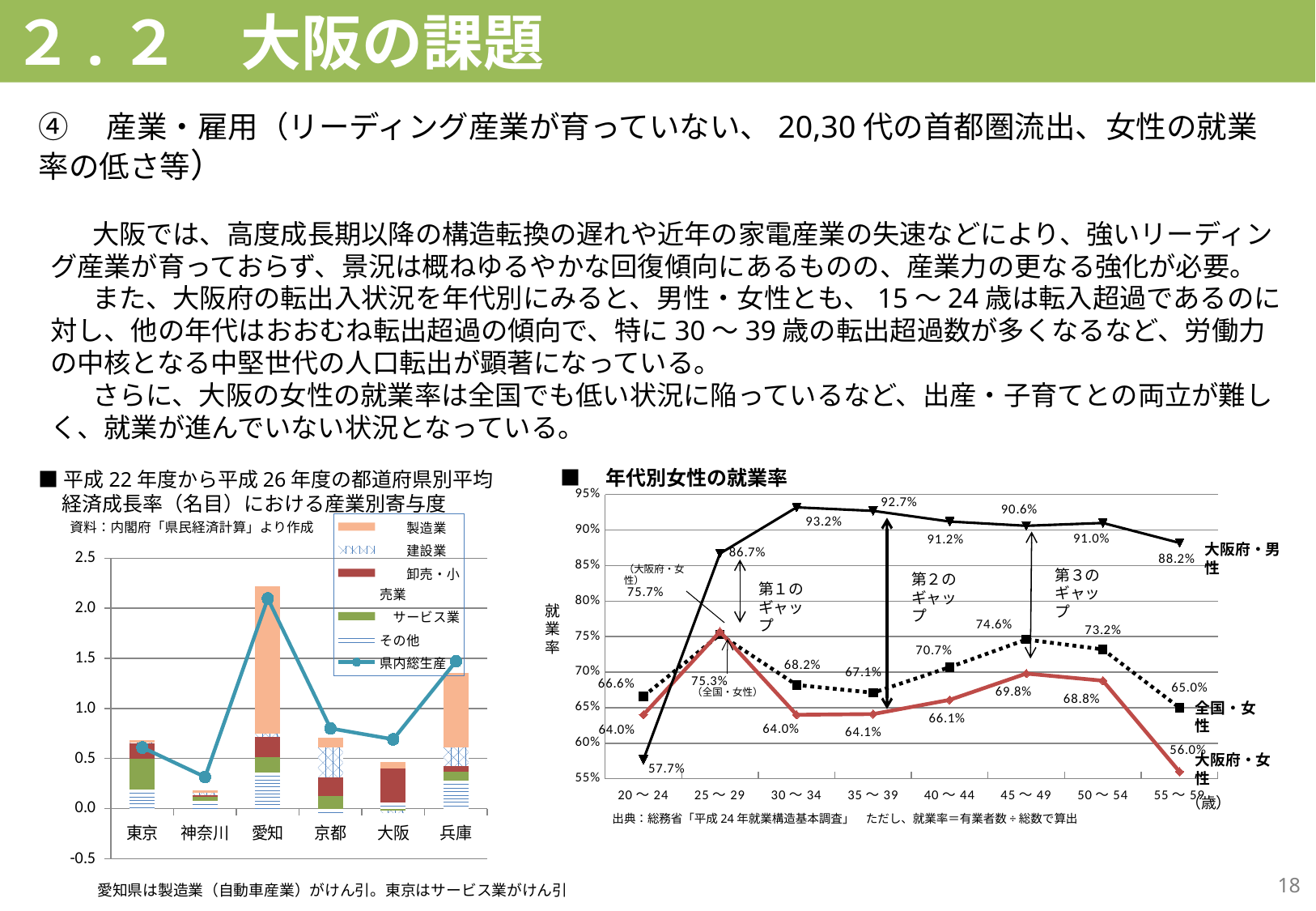
In the 年代別女性の就業率 chart, does 大阪府・男性 rise or fall from 20～24 to 30～34? rise In the 年代別女性の就業率 chart, how many age groups are shown on the x axis? 8 In the left chart on 産業別寄与度, is the 県内総生産 value for 大阪 greater or less than 1.0? less In the left chart on 産業別寄与度, how many series does the legend list? 6 In the 年代別女性の就業率 chart, what is the value for 大阪府・女性 at 25～29? 75.7% In the 年代別女性の就業率 chart, which is larger at 40～44: 全国・女性 or 大阪府・女性? 全国・女性 In the 年代別女性の就業率 chart, what is the value for 全国・女性 at 45～49? 74.6% In the left chart on 産業別寄与度, which prefecture has the highest 県内総生産 value? 愛知 In the 年代別女性の就業率 chart, what is the difference between 大阪府・男性 and 大阪府・女性 at 35～39? 28.6% In the 年代別女性の就業率 chart, what is the value for 大阪府・男性 at 55～59? 88.2% In the 年代別女性の就業率 chart, at which age group is 大阪府・女性 lowest? 55～59 In the 年代別女性の就業率 chart, at which age group is 大阪府・男性 highest? 30～34